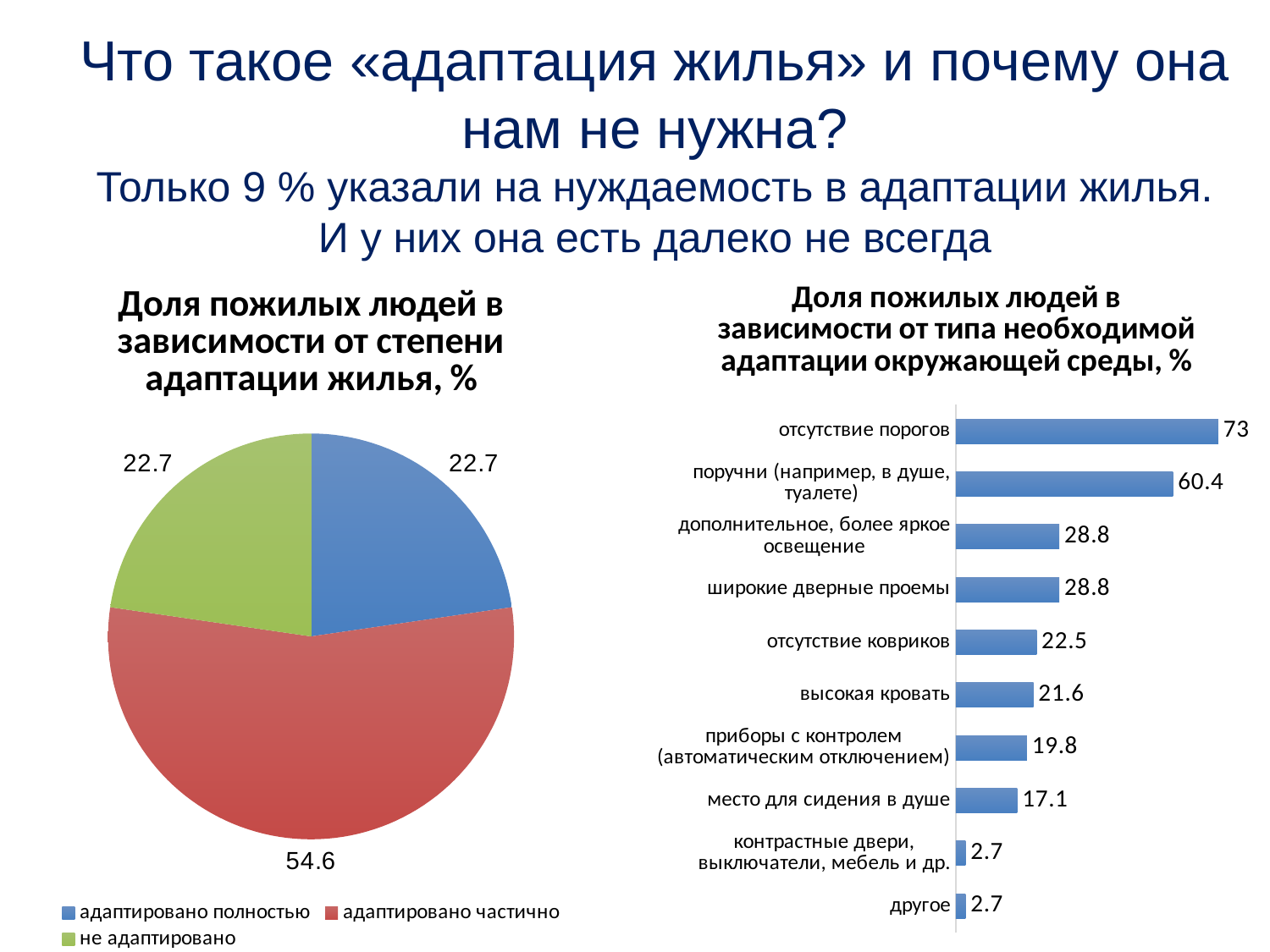
In the bar chart on the right, how many categories are shown? 10 In the bar chart on the right, which is larger: 'отсутствие ковриков' or 'место для сидения в душе'? отсутствие ковриков In the pie chart on the left, which category has the largest share? адаптировано частично What kind of chart is the chart on the left of the slide? pie chart In the bar chart 'Доля пожилых людей в зависимости от типа необходимой адаптации окружающей среды, %', what is the value for 'отсутствие порогов'? 73 In the pie chart on the left, what is the value for 'не адаптировано'? 22.7 In the bar chart on the right, what is the difference between 'отсутствие порогов' and 'поручни (например, в душе, туалете)'? 12.6 What kind of chart is the chart on the right of the slide? bar chart In the bar chart on the right, what is the value for 'высокая кровать'? 21.6 In the bar chart on the right, which category has the highest value? отсутствие порогов In the pie chart on the left, how many categories does the legend list? 3 In the pie chart 'Доля пожилых людей в зависимости от степени адаптации жилья, %', what is the value for 'адаптировано частично'? 54.6